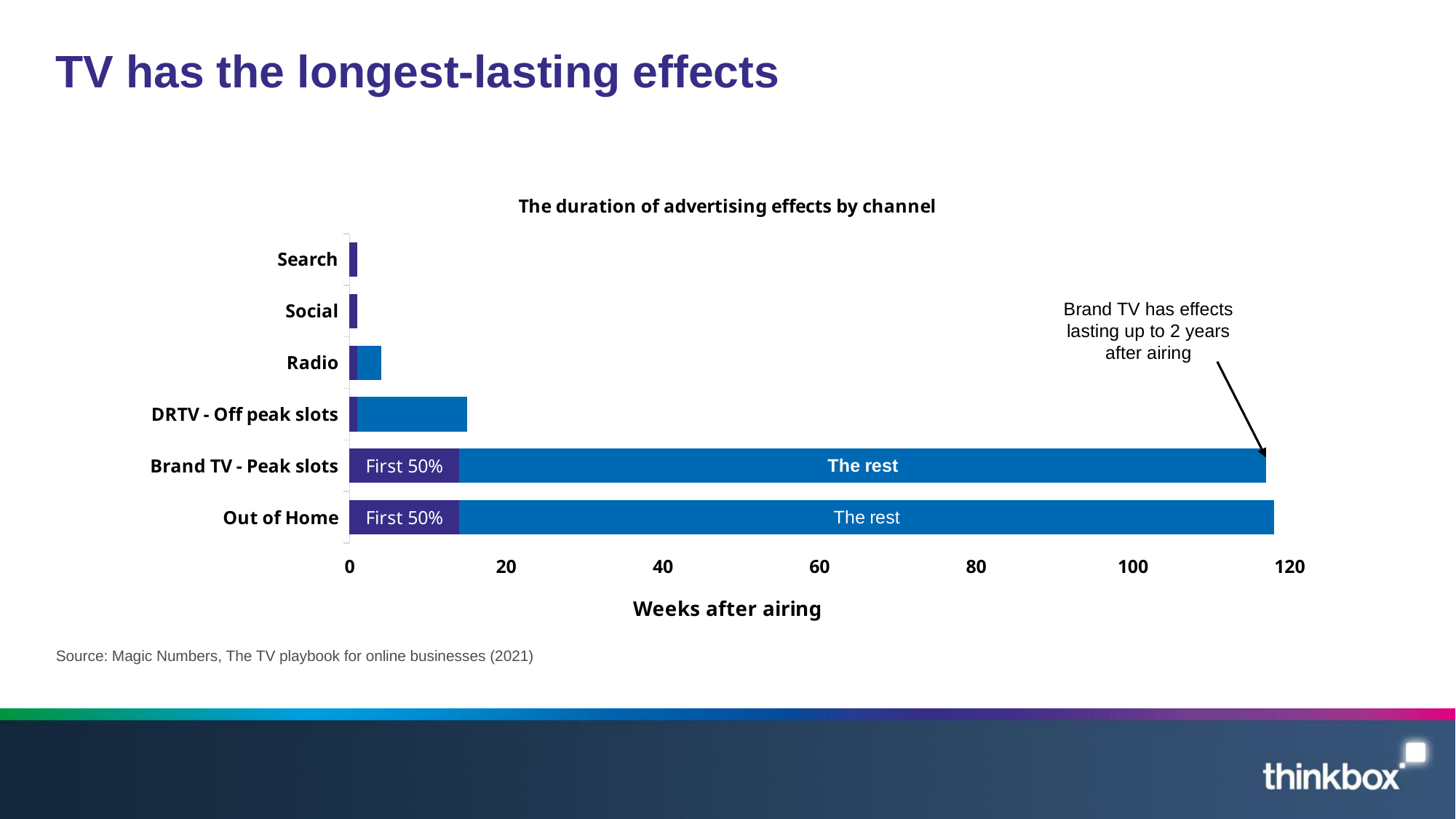
Is the value for Brand TV - Peak slots greater or less than 100 weeks? greater What is the label of the horizontal axis? Weeks after airing Is the value for Search greater or less than 20 weeks? less How many channels (categories) are plotted in the chart? 6 What type of chart is shown on the slide? Bar chart Is the value for DRTV - Off peak slots greater or less than 20 weeks? less Which has a longer duration of advertising effect, Radio or Social? Radio Which has a longer duration of advertising effect, Brand TV - Peak slots or DRTV - Off peak slots? Brand TV - Peak slots What is the title of the chart? The duration of advertising effects by channel Which has a longer duration of advertising effect, DRTV - Off peak slots or Radio? DRTV - Off peak slots